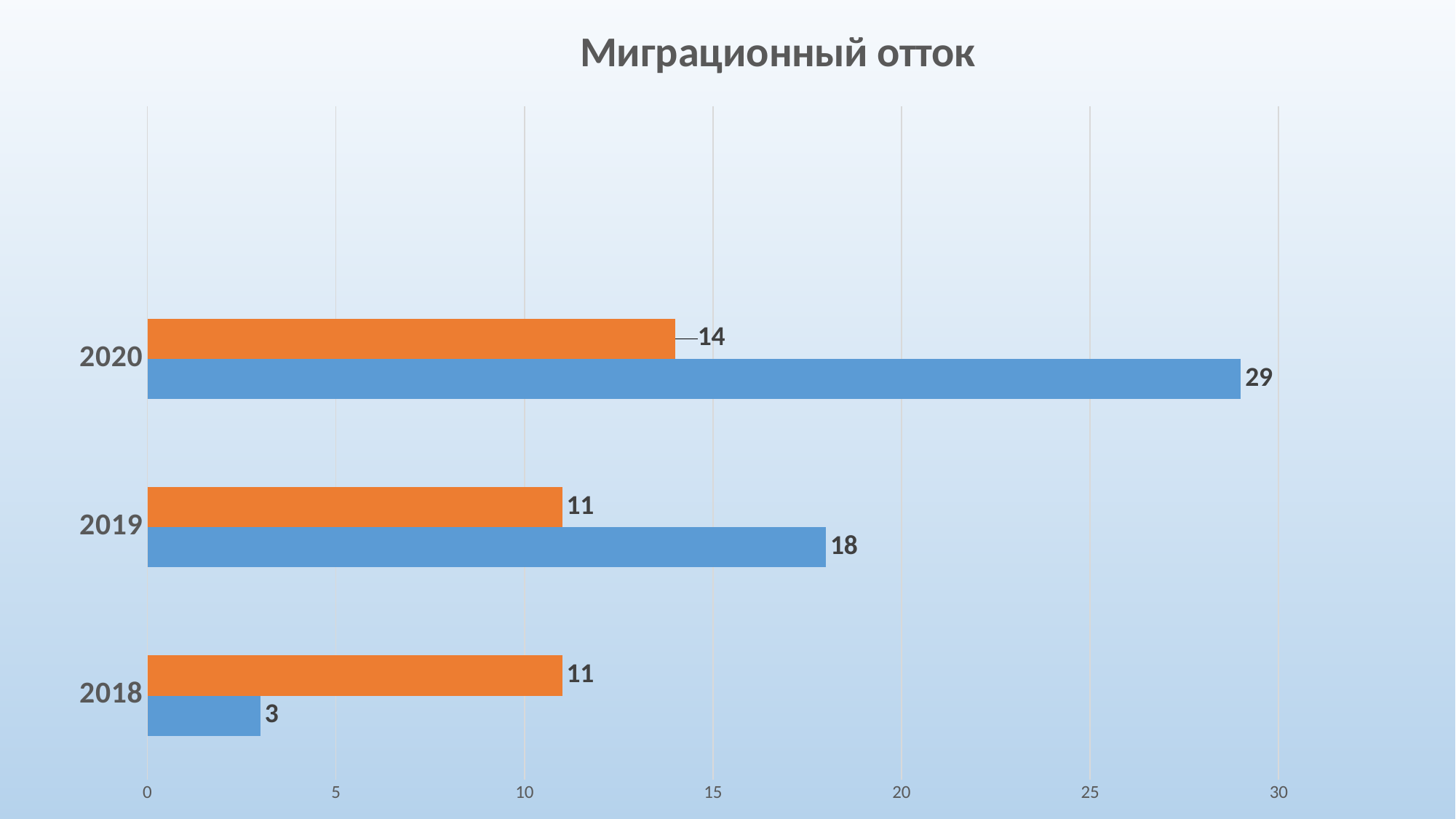
Which year has the lowest value for the blue bars? 2018 What is the title of the chart? Миграционный отток What type of chart is shown on the slide? bar chart For 2018, which bar is larger, the blue or the orange one? orange What is the value of the blue bar for 2020? 29 Do the blue bar values rise or fall from 2018 to 2020? rise What is the value of the orange bar for 2019? 11 What is the difference between the blue and orange bars for 2020? 15 What is the value of the orange bar for 2020? 14 What is the value of the blue bar for 2018? 3 How many years (categories) are shown on the chart? 3 Which year has the highest value for the blue bars? 2020